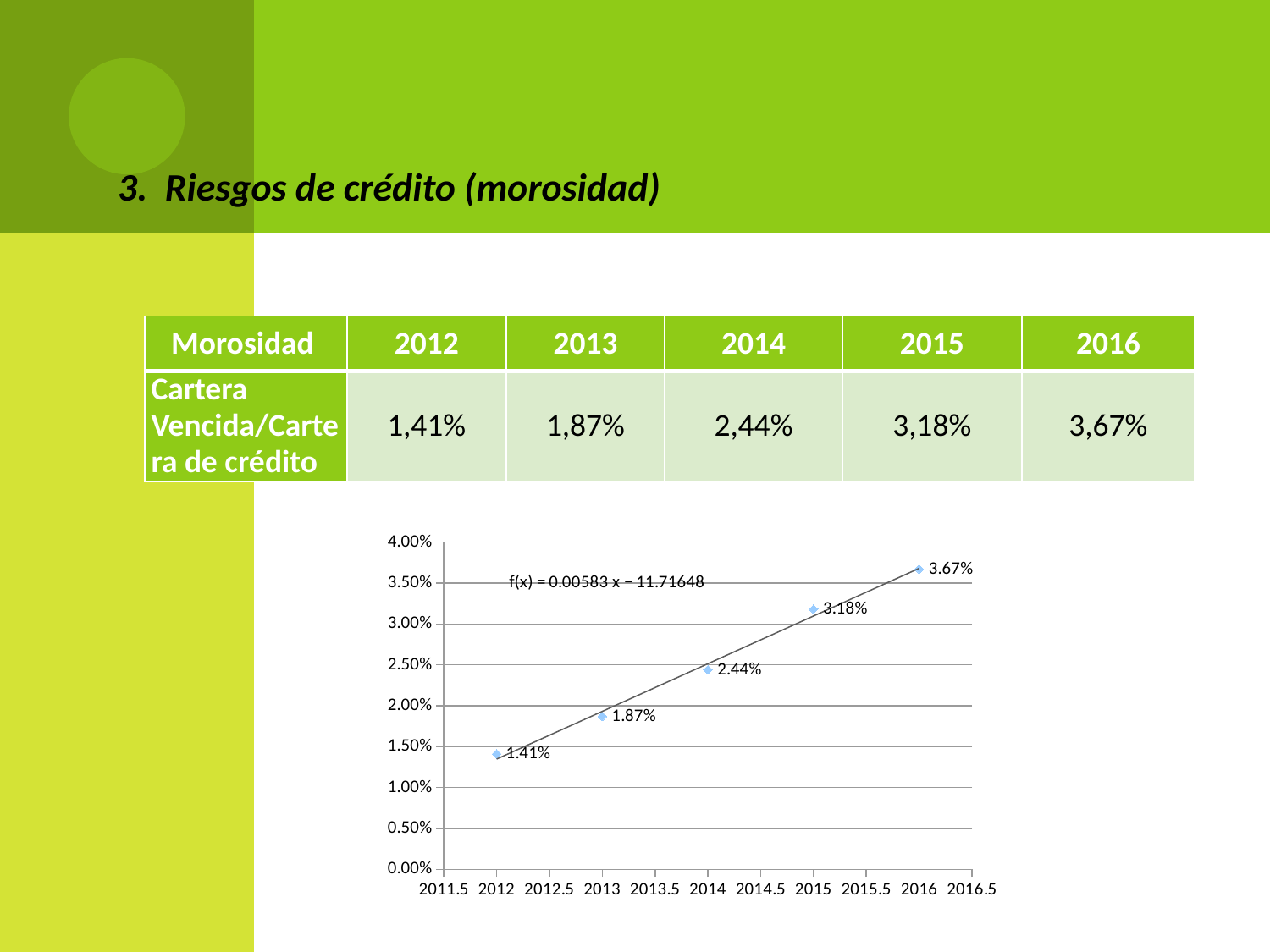
What value is plotted for 2012 in the chart? 1.41% Which year has the lowest plotted value in the chart? 2012 What value is plotted for 2014 in the chart? 2.44% What value is plotted for 2016 in the chart? 3.67% How many data points are plotted in the chart? 5 Is the value plotted for 2015 greater or less than 3.00%? greater Do the plotted values rise or fall from 2012 to 2016? rise What is the difference between the values plotted for 2015 and 2014? 0.74% What kind of chart is shown on the slide? scatter chart What is the difference between the values plotted for 2016 and 2012? 2.26% Which is larger, the value for 2013 or the value for 2015? 2015 Which year has the highest plotted value in the chart? 2016